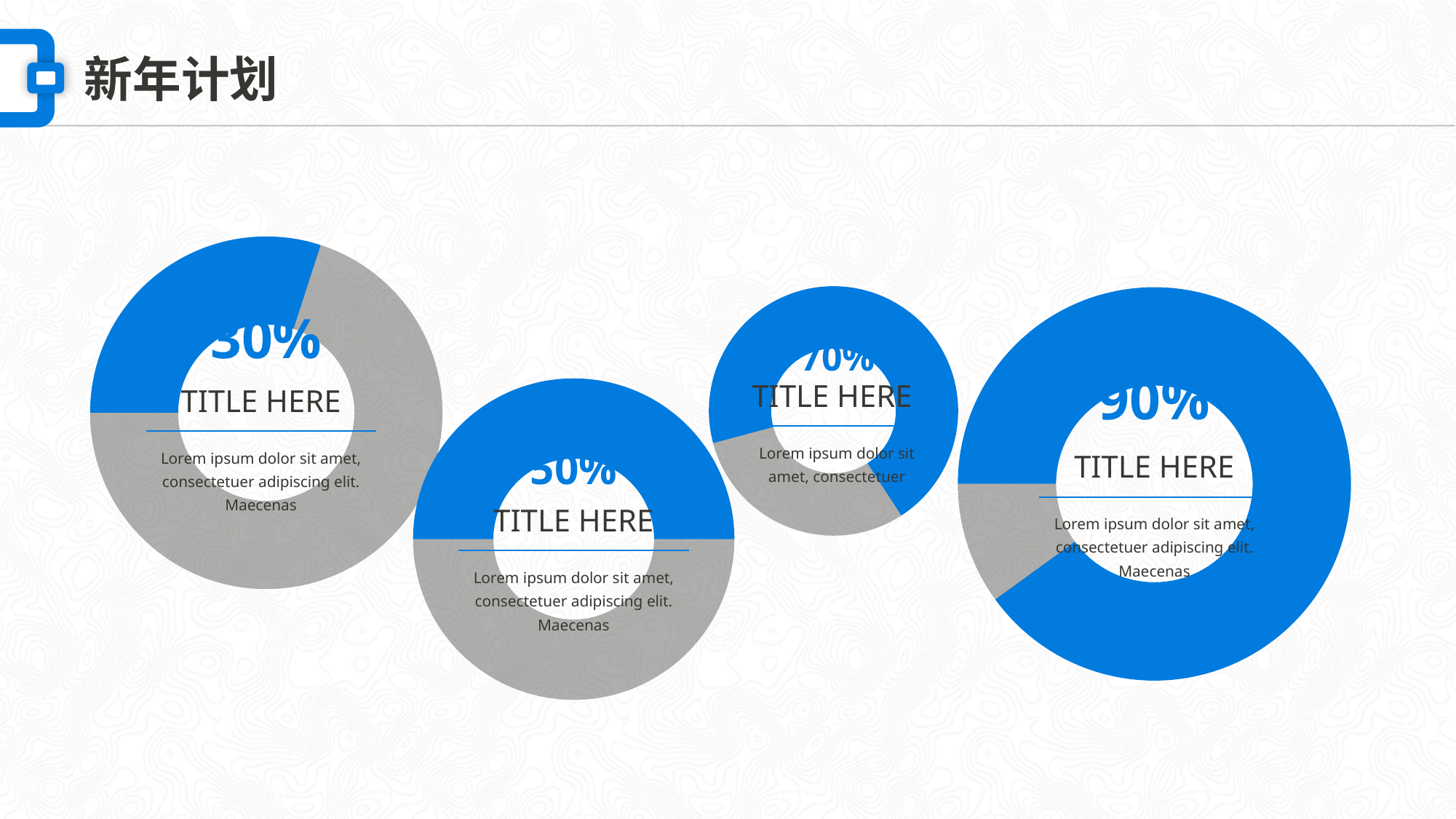
What percentage is shown in the second donut chart from the left? 50% What percentage is shown in the third donut chart from the left (the smallest one)? 70% Which donut chart shows the highest percentage? The rightmost chart (90%) What share of the rightmost donut chart is grey (not blue)? 10% Which donut chart shows the lowest percentage? The leftmost chart (30%) Which shows a larger percentage: the second donut chart from the left or the third donut chart from the left? The third chart from the left (70%) What percentage is shown in the rightmost donut chart? 90% Do the percentages in the donut charts rise or fall from left to right across the slide? Rise What percentage is shown in the leftmost donut chart? 30% What kind of chart is the leftmost chart on the slide? Donut (pie) chart What is the difference between the percentage in the rightmost donut chart and the percentage in the leftmost donut chart? 60% How many donut charts are shown on the slide? 4